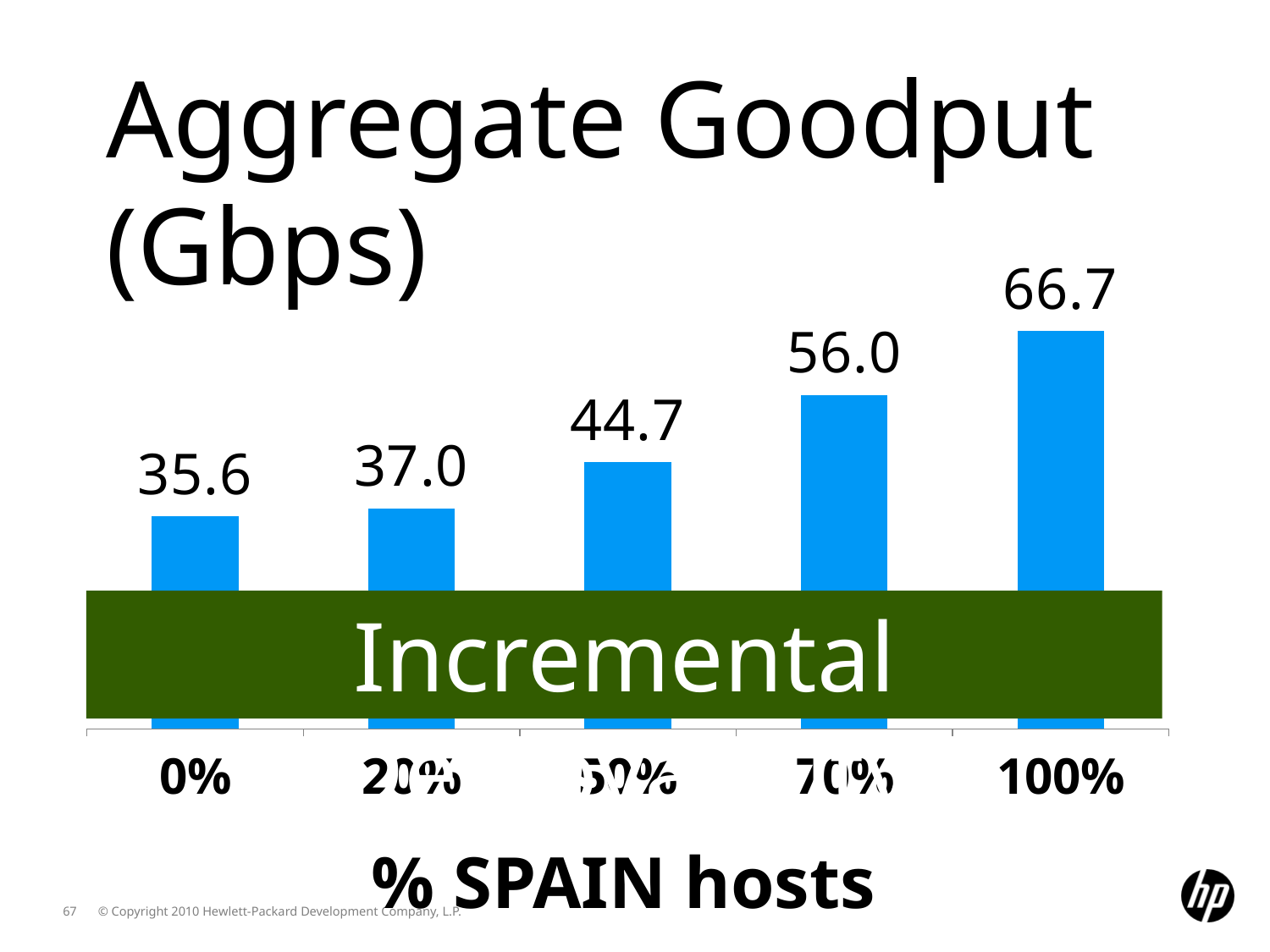
What is the aggregate goodput for 100% SPAIN hosts? 66.7 Which has a larger aggregate goodput, 0% SPAIN hosts or 100% SPAIN hosts? 100% What kind of chart is shown on the slide? bar chart What value is labelled on the middle (third) bar of the chart? 44.7 What value is labelled on the fourth bar from the left? 56.0 Do the aggregate goodput values rise or fall as the percentage of SPAIN hosts increases? rise How many bars are shown in the chart? 5 Which percentage of SPAIN hosts has the highest aggregate goodput? 100% What is the aggregate goodput for 0% SPAIN hosts? 35.6 What is the label on the x axis of the chart? % SPAIN hosts What is the difference in aggregate goodput between 100% and 0% SPAIN hosts? 31.1 Which percentage of SPAIN hosts has the lowest aggregate goodput? 0%